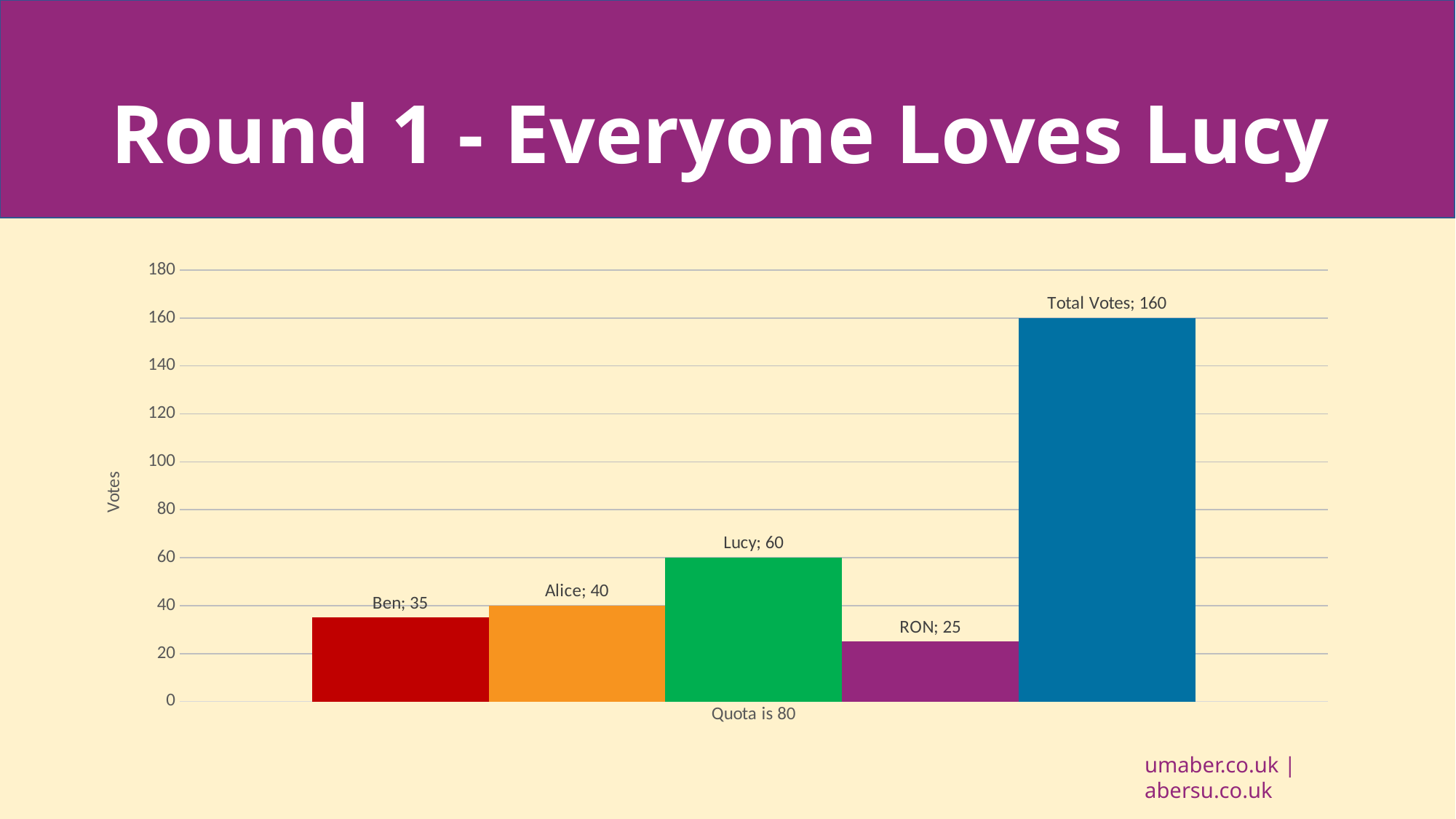
What kind of chart is shown on the slide? bar chart Who received more votes, Alice or Ben? Alice How many votes did Ben receive? 35 Which bar is the tallest on the chart? Total Votes What is the label of the vertical axis? Votes What is the difference between Total Votes and Lucy's votes? 100 What is the value of the Total Votes bar? 160 Which candidate received the fewest votes? RON How many bars are plotted on the chart? 5 How many votes did Lucy receive? 60 What is the difference in votes between Lucy and Alice? 20 Is the value for RON greater or less than 40? less